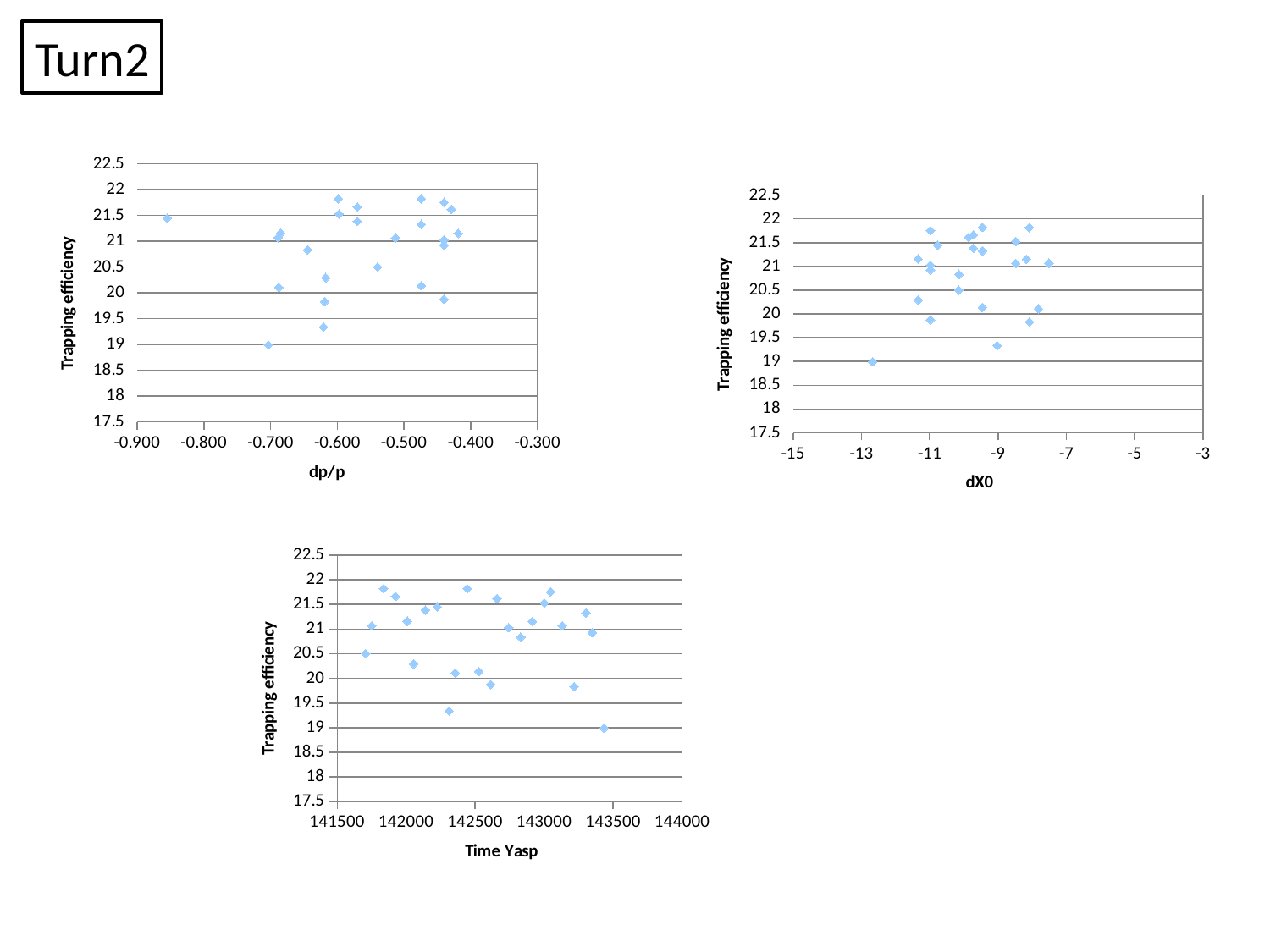
In the chart with x-axis 'dX0', is the highest trapping efficiency plotted greater or less than 21.5? greater In the chart with x-axis 'dp/p', is the trapping efficiency of the leftmost point (near dp/p = -0.850) greater or less than 21? greater In the chart with x-axis 'dX0', is the trapping efficiency of the leftmost point (near dX0 = -13) greater or less than 19.5? less What is the y-axis title of the chart with x-axis 'dp/p'? Trapping efficiency What kind of chart is the chart with x-axis 'dp/p'? scatter chart Which has the higher trapping efficiency: the leftmost point in the 'dp/p' chart or the leftmost point in the 'dX0' chart? the leftmost point in the dp/p chart What kind of chart is the chart with x-axis 'Time Yasp'? scatter chart What is the x-axis title of the top-right chart? dX0